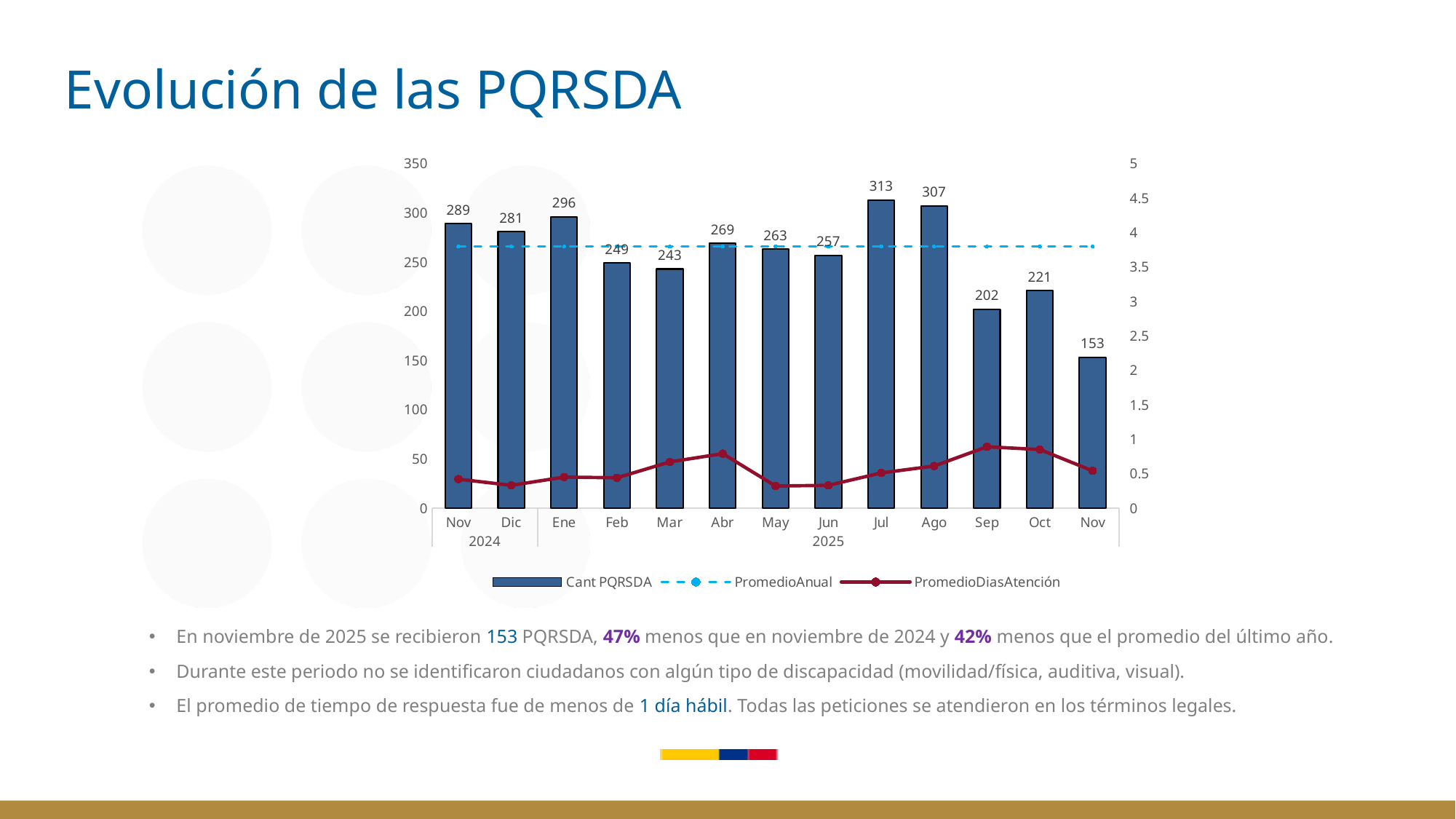
Do the Cant PQRSDA values rise or fall from Jul 2025 to Nov 2025? fall Which month has the lowest Cant PQRSDA value? Nov 2025 What is the difference between the Cant PQRSDA values for Jul 2025 and Nov 2025? 160 Which is larger, the Cant PQRSDA value for Sep 2025 or Oct 2025? Oct 2025 Is the PromedioDiasAtención value for May 2025 greater or less than 0.5? less How many months are shown on the x axis of the chart? 13 Which month has the highest Cant PQRSDA value? Jul 2025 How many series does the chart legend list? 3 What is the Cant PQRSDA value for Mar 2025? 243 Is the PromedioDiasAtención value for Sep 2025 greater or less than 0.5? greater What is the Cant PQRSDA value for Jul 2025? 313 What is the Cant PQRSDA value for Nov 2024? 289